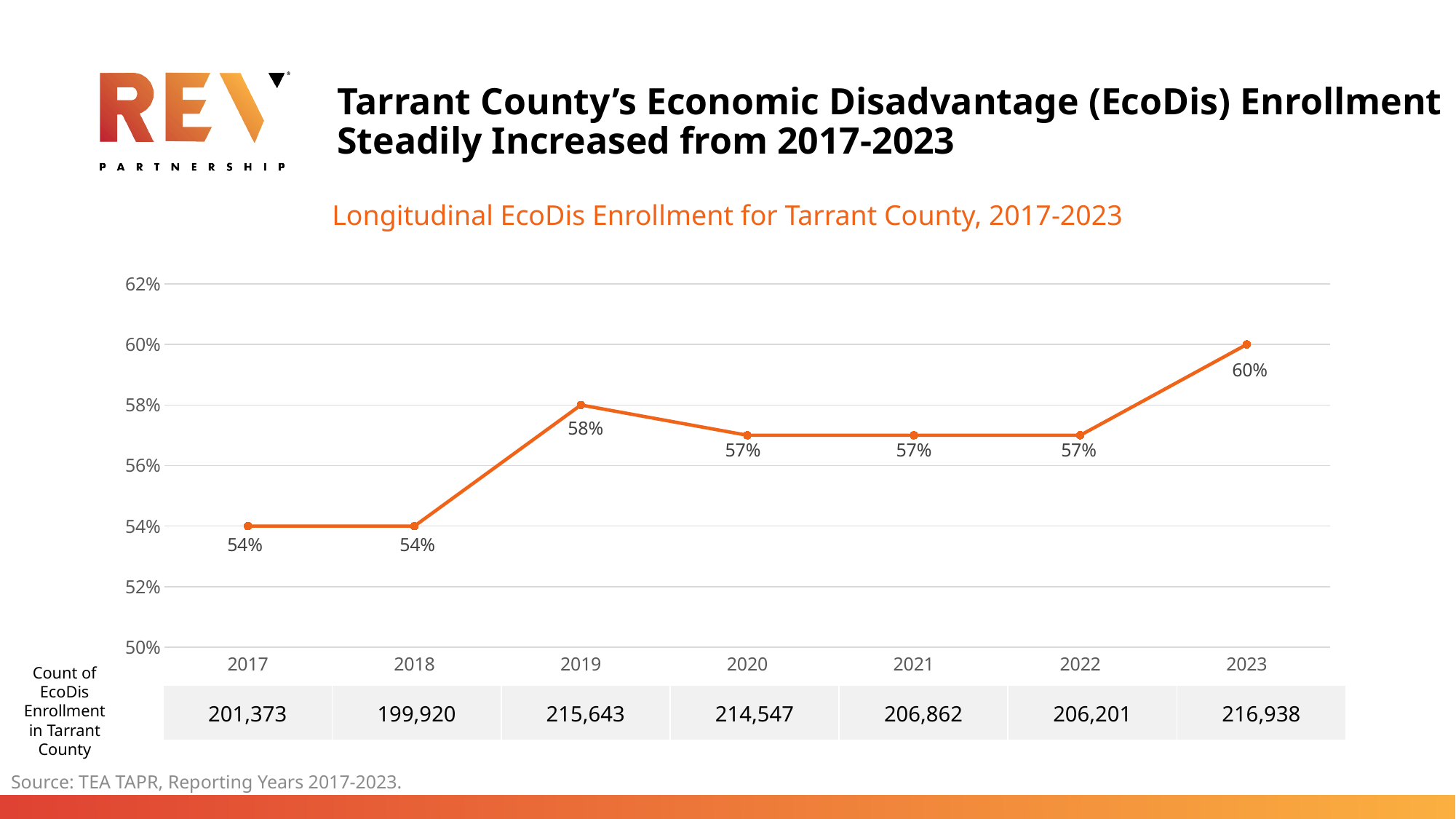
Which year has a higher EcoDis enrollment percentage, 2019 or 2020? 2019 What is the title of the chart? Longitudinal EcoDis Enrollment for Tarrant County, 2017-2023 Which year has the highest EcoDis enrollment percentage? 2023 What is the difference in EcoDis enrollment percentage between 2023 and 2017? 6% Which year has the lowest count of EcoDis enrollment in Tarrant County? 2018 What is the count of EcoDis enrollment in Tarrant County for 2021? 206,862 What is the difference between the count of EcoDis enrollment in 2023 and in 2022? 10,737 What is the EcoDis enrollment percentage for Tarrant County in 2023? 60% How many years are plotted on the chart? 7 Does the EcoDis enrollment percentage rise or fall from 2022 to 2023? Rise What is the EcoDis enrollment percentage for Tarrant County in 2019? 58% What kind of chart is shown on the slide? Line chart